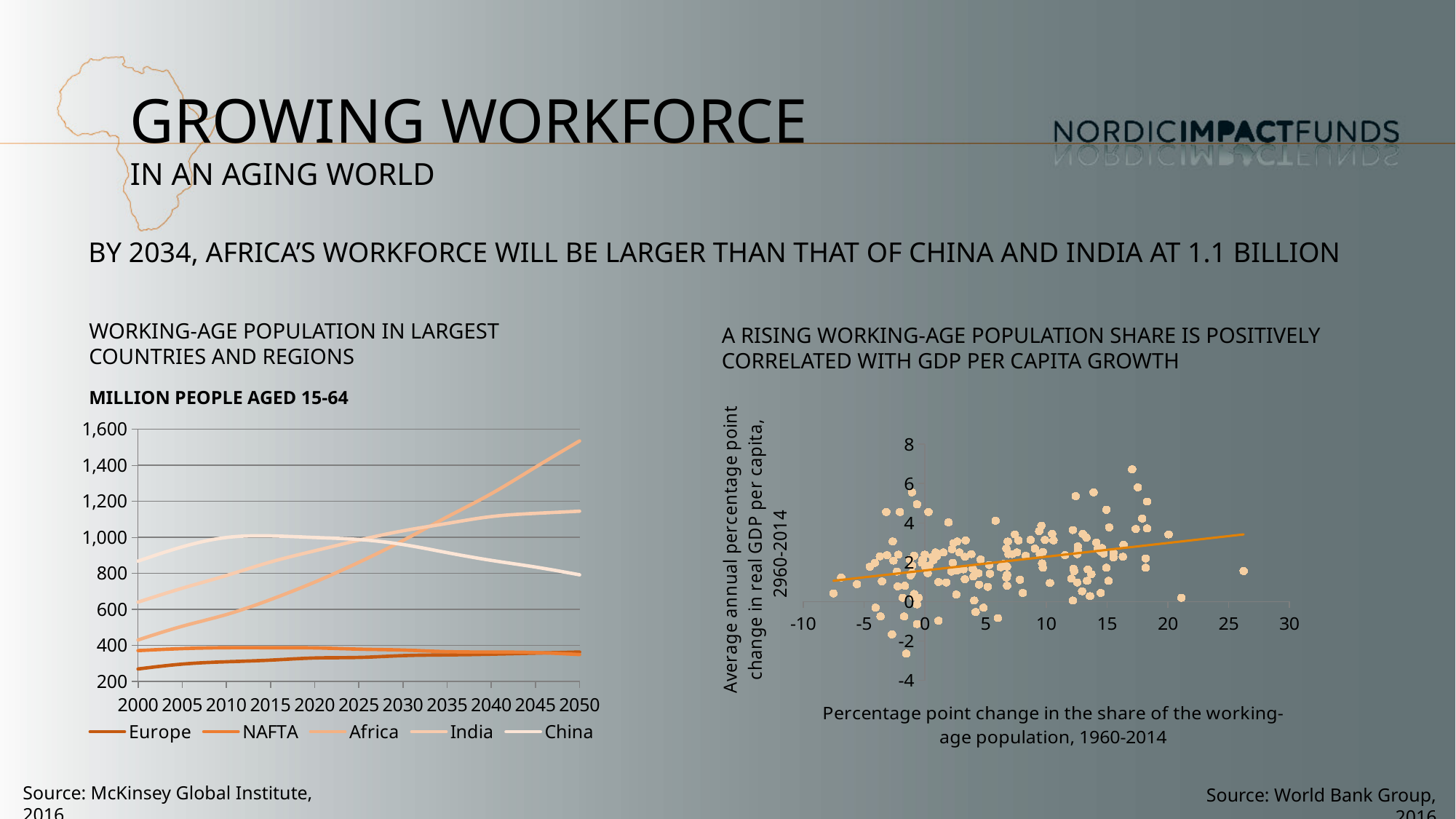
In the 'Working-age population in largest countries and regions' chart, is the value for Africa in 2050 greater or less than 1,400? greater What kind of chart is the 'Working-age population in largest countries and regions' chart? line chart What kind of chart is the chart on the right of the slide, under 'A rising working-age population share is positively correlated with GDP per capita growth'? scatter chart In the 'Working-age population in largest countries and regions' chart, which is larger in 2000, India or China? China In the 'Working-age population in largest countries and regions' chart, which series has the highest value in 2050? Africa In the 'Working-age population in largest countries and regions' chart, is the value for Europe in 2000 greater or less than 400? less How many series does the legend of the 'Working-age population in largest countries and regions' chart list? 5 In the scatter chart on the right of the slide, does the trend line rise or fall as the x-axis value increases? rise In the 'Working-age population in largest countries and regions' chart, how many year labels are shown on the x axis? 11 In the 'Working-age population in largest countries and regions' chart, does the Africa line rise or fall from 2000 to 2050? rise In the 'Working-age population in largest countries and regions' chart, is the value for China in 2050 greater or less than 1,000? less In the 'Working-age population in largest countries and regions' chart, which series has the lowest value in 2000? Europe